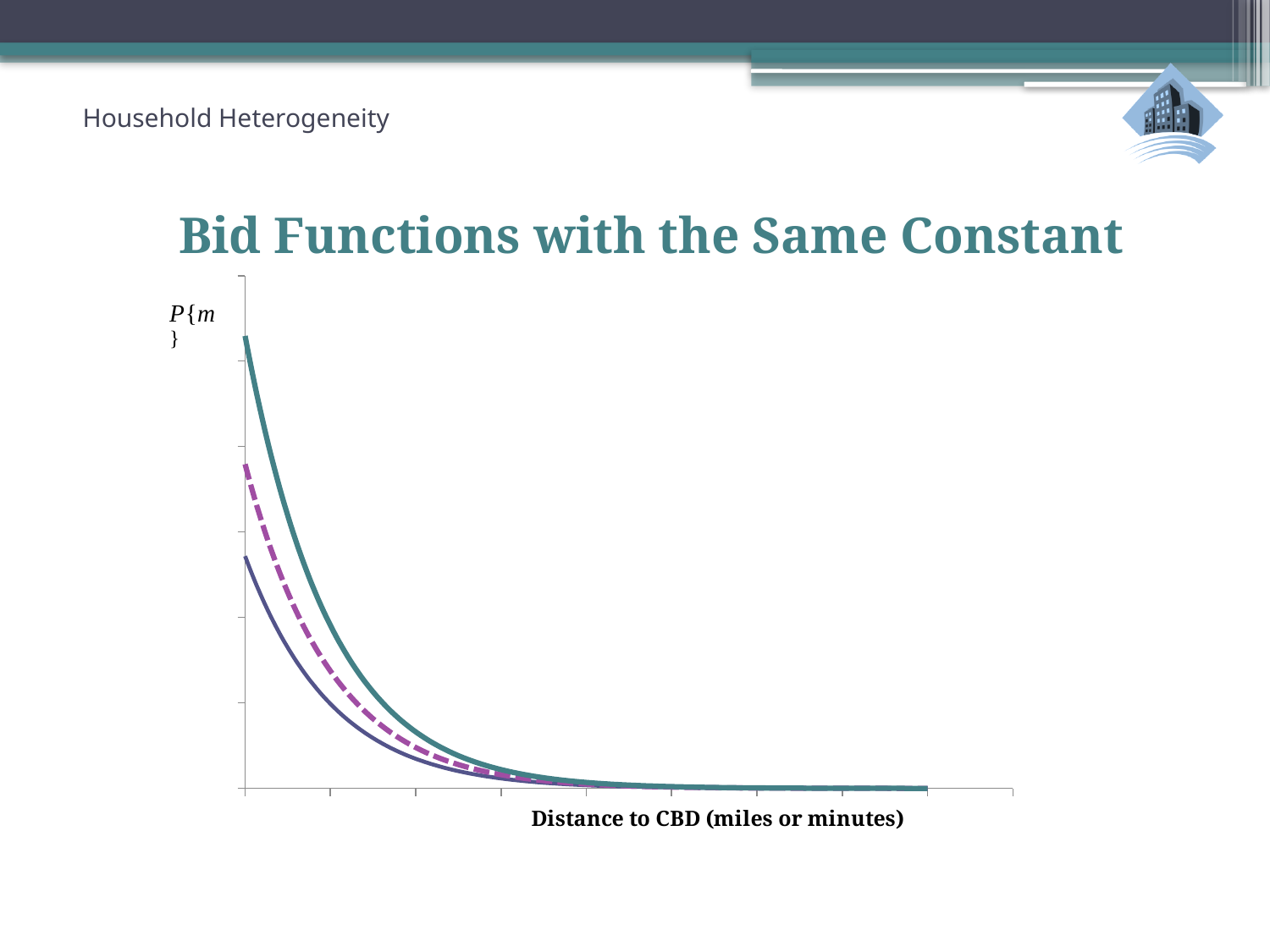
Which line has the lowest value at the left edge of the chart (closest to the CBD)? the solid dark blue line At the left edge of the chart, is the dashed purple line or the solid dark blue line higher? the dashed purple line What is the title of the chart? Bid Functions with the Same Constant What kind of chart is shown on the slide? line chart How many lines are plotted on the chart? 3 Which line has the highest value at the left edge of the chart (closest to the CBD)? the solid teal line Do the plotted values rise or fall as distance to the CBD increases? fall At the left edge of the chart, is the solid teal line or the dashed purple line higher? the solid teal line What is the label on the horizontal axis of the chart? Distance to CBD (miles or minutes)